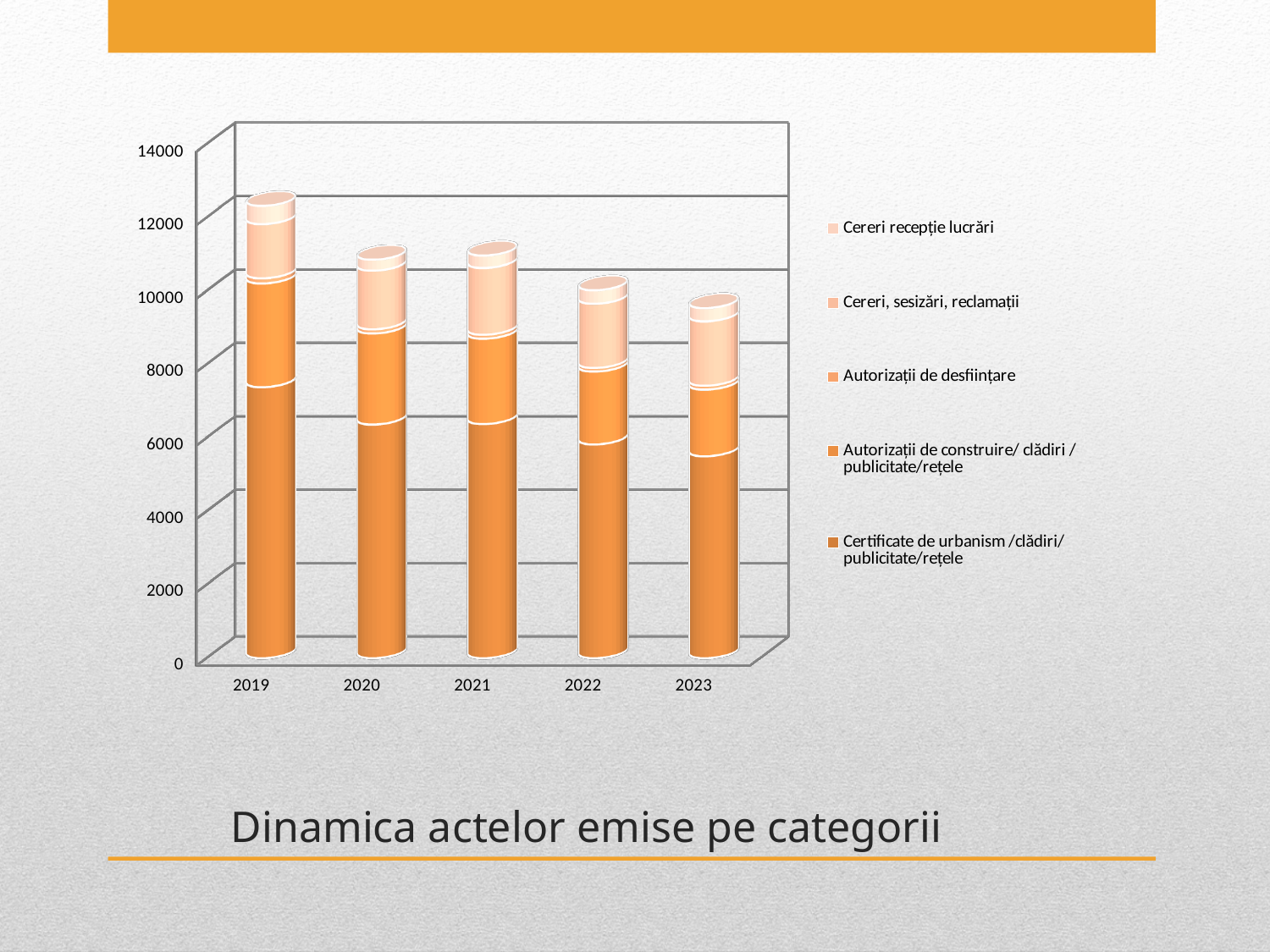
How many series does the chart's legend list? 5 Is the total for 2022 greater or less than 12000? less Is the total for 2019 greater or less than 12000? greater Is the total for 2023 greater or less than 12000? less What kind of chart is shown on the slide? Stacked bar chart Which year has the highest total bar in the chart? 2019 Which year has the lowest total bar in the chart? 2023 Do the total bar heights generally rise or fall from 2019 to 2023? fall Which year has a larger total bar, 2019 or 2023? 2019 What is the title shown below the chart on the slide? Dinamica actelor emise pe categorii How many years are shown on the x axis of the chart? 5